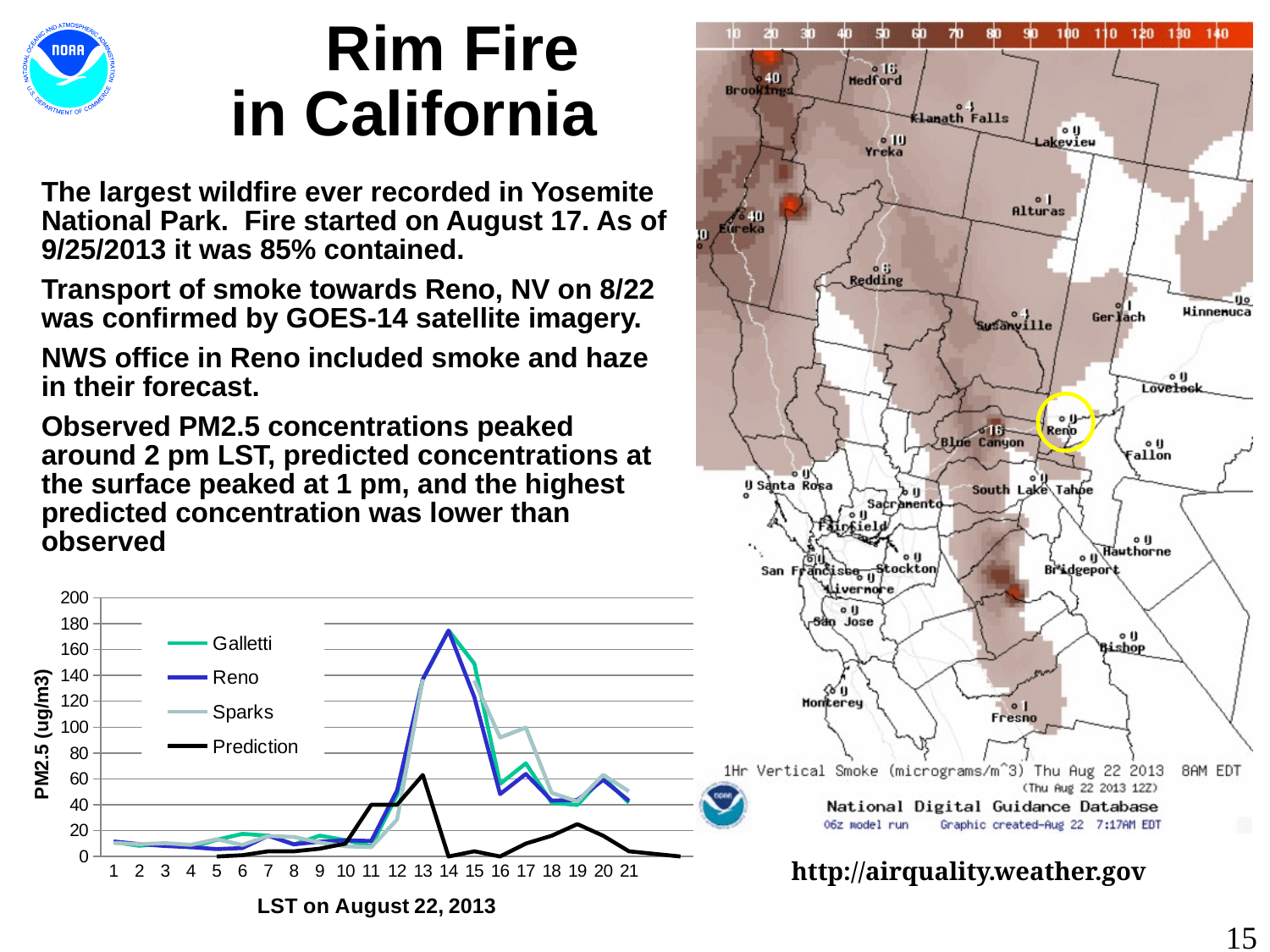
What kind of chart is shown at the bottom left of the slide? line chart In the PM2.5 chart, is the Prediction value at hour 13 greater or less than 80? less In the PM2.5 chart, is the Reno value at hour 14 greater or less than 160? greater In the PM2.5 chart, which series has the lowest peak value? Prediction How many series does the legend of the PM2.5 chart list? 4 In the PM2.5 chart, is the Prediction value at hour 13 greater or less than 40? greater In the PM2.5 chart, at hour 14, which is larger: the Reno value or the Prediction value? Reno In the PM2.5 chart, does the Reno series rise or fall from hour 14 to hour 16? fall What is the y-axis label of the PM2.5 chart? PM2.5 (ug/m3) How many hourly points are labelled along the x axis of the PM2.5 chart? 21